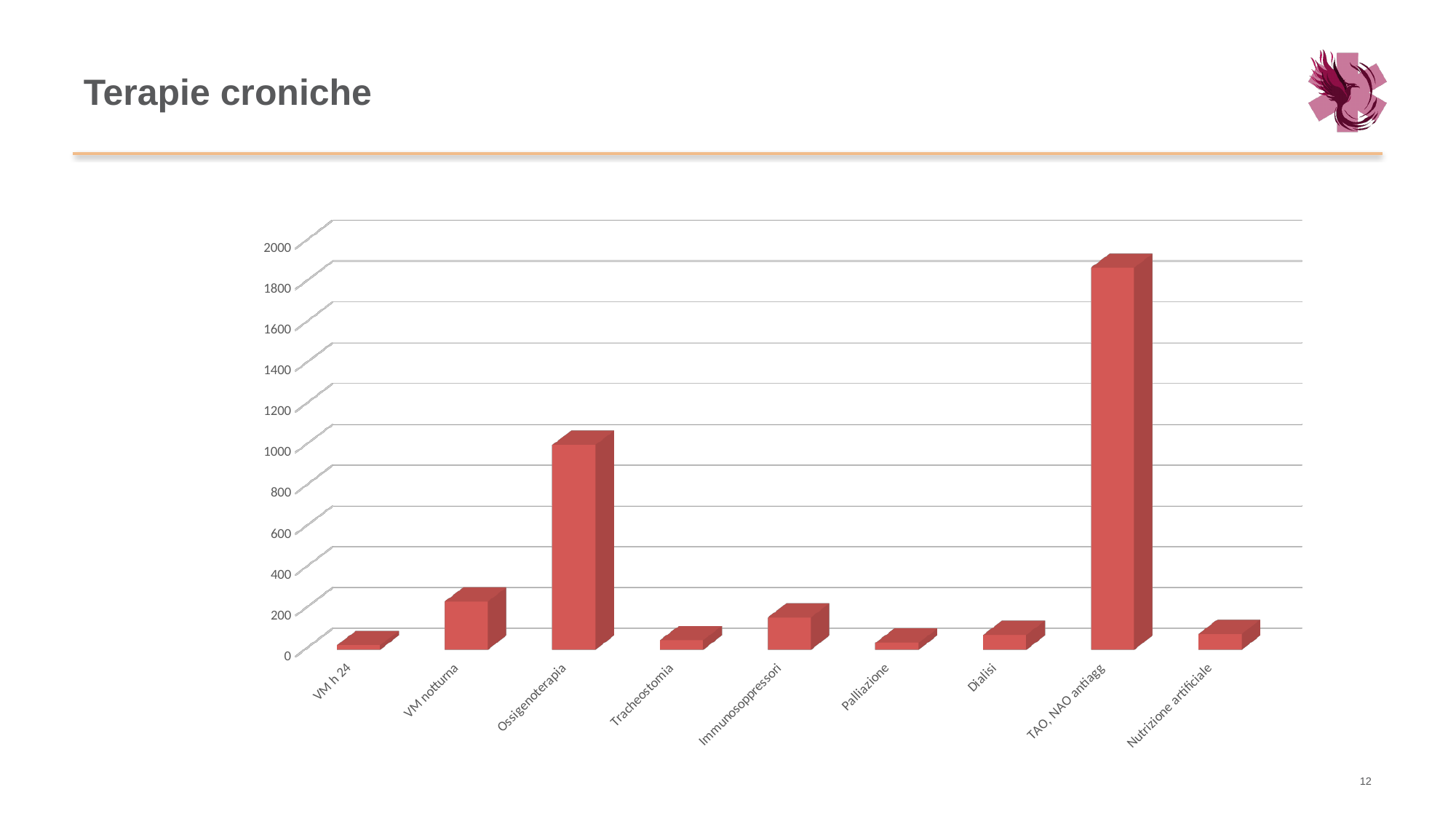
Is the value for Ossigenoterapia greater or less than 800? greater Is the value for VM notturna greater or less than 400? less Is the value for TAO, NAO antiagg greater or less than 1600? greater How many categories are shown on the x axis of the chart? 9 What kind of chart is shown on the slide? bar chart Which is larger, the value for Immunosoppressori or the value for Tracheostomia? Immunosoppressori What is the title of the slide containing the chart? Terapie croniche Which category has the highest value in the chart? TAO, NAO antiagg Which is larger, the value for Ossigenoterapia or the value for VM notturna? Ossigenoterapia Which is larger, the value for TAO, NAO antiagg or the value for Ossigenoterapia? TAO, NAO antiagg